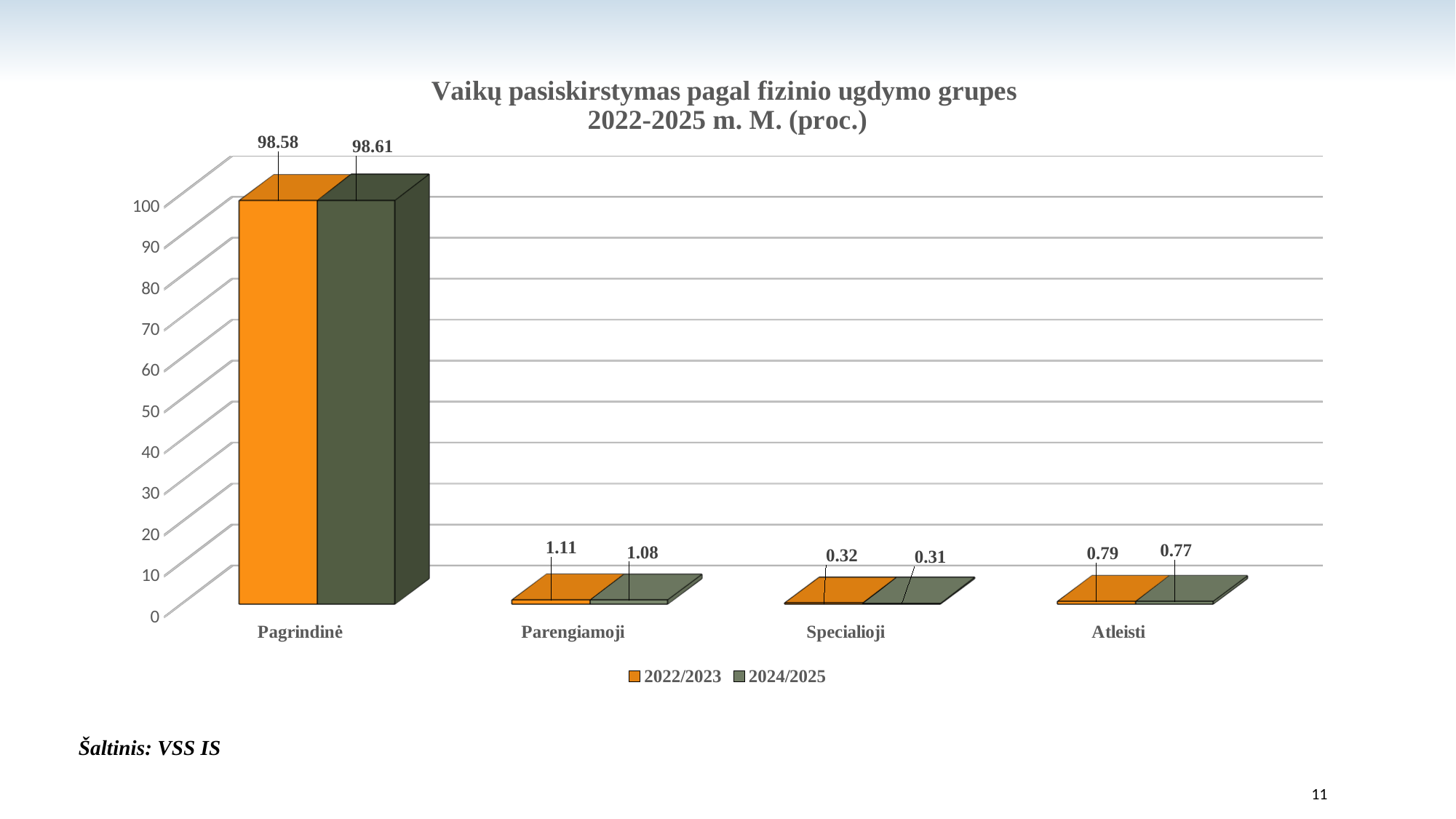
What is the value for Pagrindinė in the 2022/2023 series? 98.58 What is the difference between the 2022/2023 and 2024/2025 values for Parengiamoji? 0.03 Which category has the highest value in the 2024/2025 series? Pagrindinė What is the value for Atleisti in the 2022/2023 series? 0.79 What is the value for Pagrindinė in the 2024/2025 series? 98.61 How many series does the legend list? 2 What is the value for Parengiamoji in the 2022/2023 series? 1.11 Is the 2022/2023 value for Pagrindinė greater or less than 90? greater How many categories are shown on the x axis? 4 Which category has the lowest value in the 2022/2023 series? Specialioji What kind of chart is shown on the slide? bar chart What is the value for Specialioji in the 2024/2025 series? 0.31